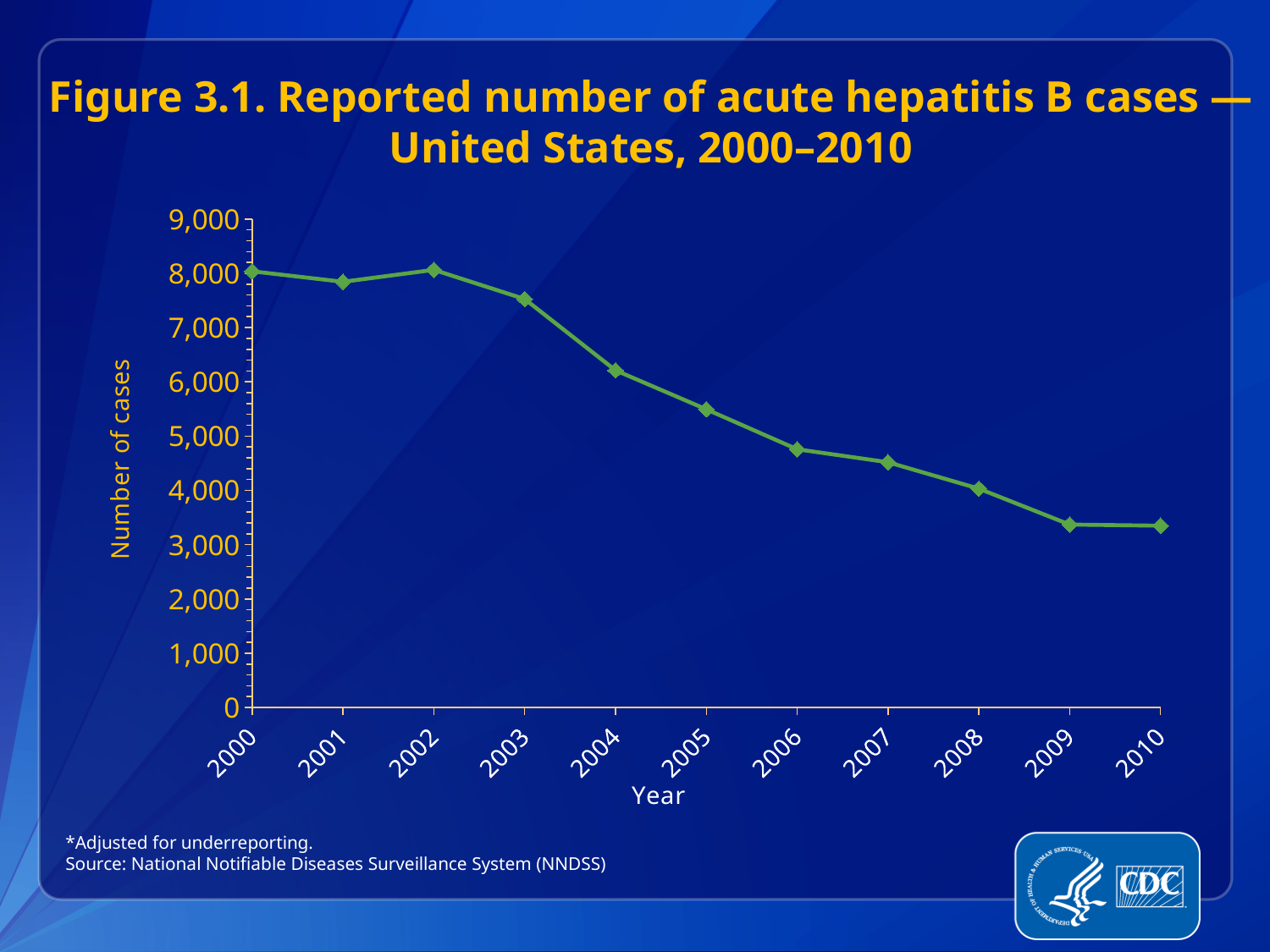
Is the number of cases for 2005 greater or less than 6,000? less What is the label on the vertical axis of the chart? Number of cases Which year had more reported cases, 2000 or 2010? 2000 Is the number of cases for 2009 greater or less than 3,000? greater Is the number of cases for 2003 greater or less than 7,000? greater How many years (data points) are plotted on the chart? 11 What kind of chart is shown on the slide? line chart Do the reported numbers of acute hepatitis B cases generally rise or fall from 2000 to 2010? fall What is the label on the horizontal axis of the chart? Year Which year had more reported cases, 2003 or 2004? 2003